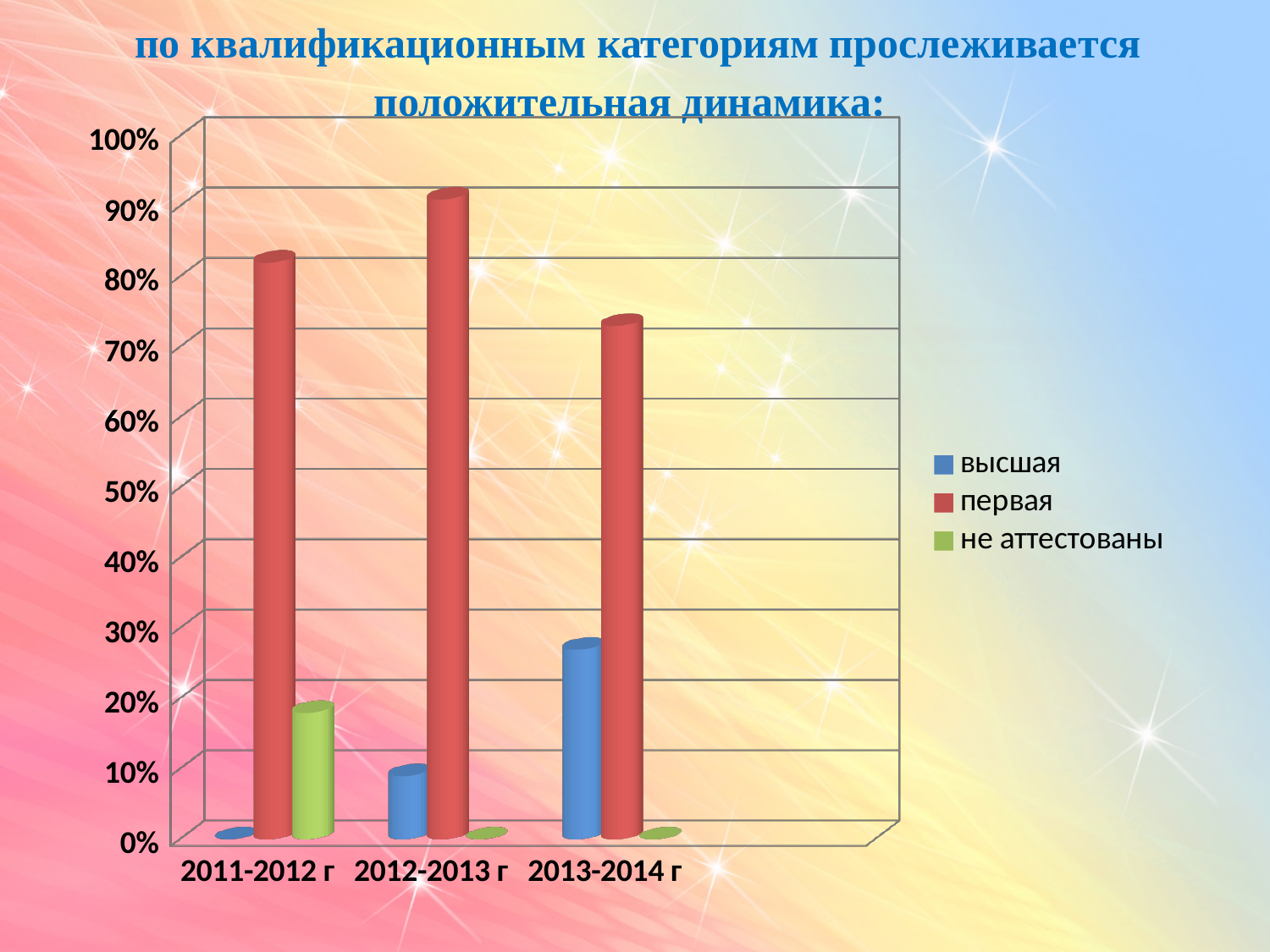
In which academic year is the value for "первая" lowest? 2013-2014 г How many series does the legend list? 3 Is the value for "не аттестованы" in 2011-2012 г greater or less than 30%? less Which is larger in 2012-2013 г: the value for "высшая" or the value for "первая"? первая Is the value for "первая" in 2012-2013 г greater or less than 80%? greater In which academic year is the value for "первая" highest? 2012-2013 г Which colour represents the "не аттестованы" series in the legend? green Is the value for "высшая" in 2013-2014 г greater or less than 20%? greater In which academic year is the value for "высшая" highest? 2013-2014 г Does the value for "высшая" rise or fall from 2011-2012 г to 2013-2014 г? rise What kind of chart is shown on the slide? bar chart How many categories (academic years) are shown on the x axis? 3